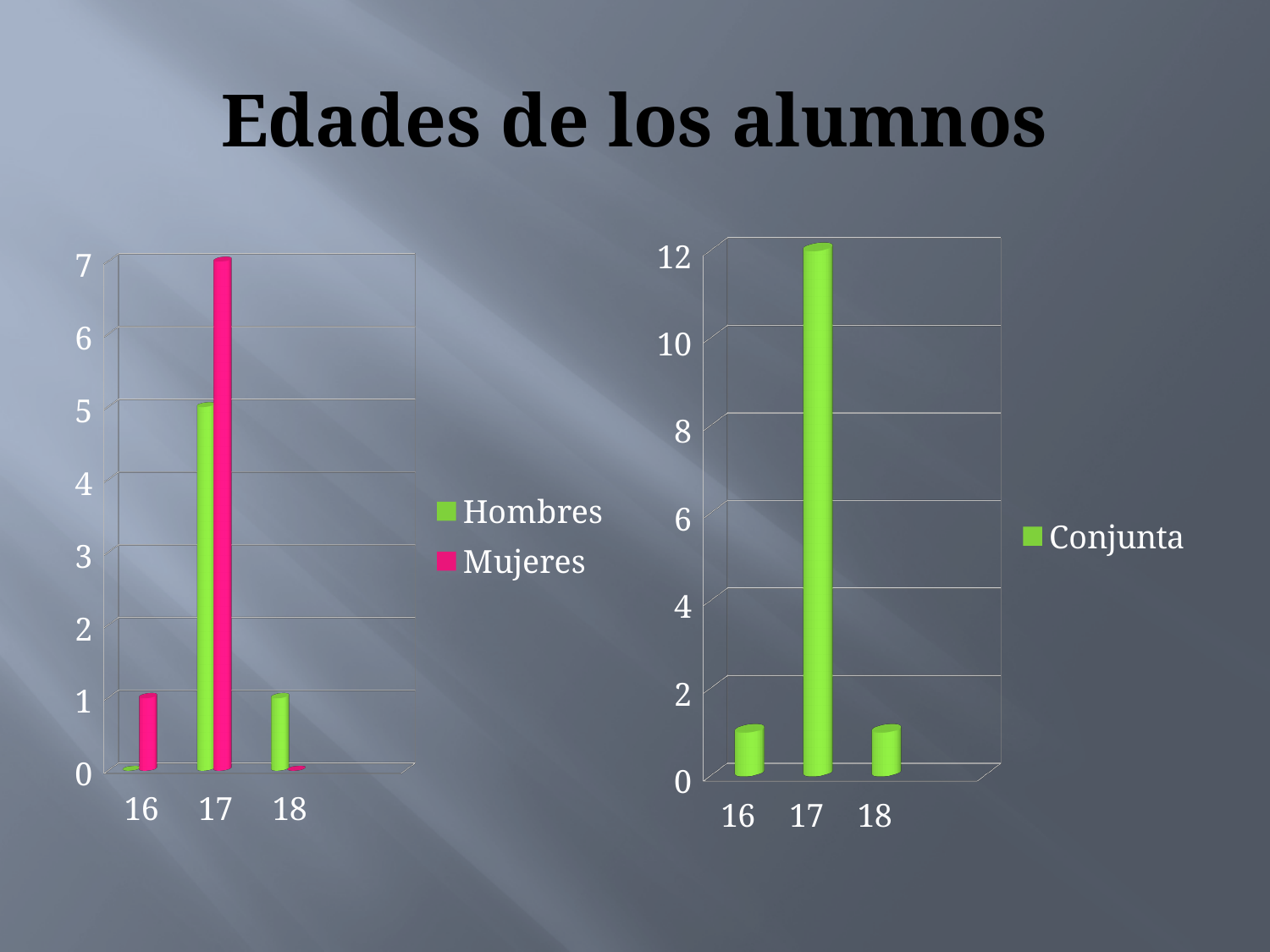
In the right chart, what is the value for Conjunta at age 17? 12 In the left chart, which series has the larger value at age 17, Hombres or Mujeres? Mujeres In the left chart, what is the value for Hombres at age 18? 1 In the left chart, what is the value for Mujeres at age 16? 1 In the left chart, what is the difference between Mujeres and Hombres at age 17? 2 In the left chart, how many series does the legend list? 2 What kind of chart is the right chart? bar chart In the right chart, which age has the highest value? 17 In the right chart, is the value for age 16 greater or less than 2? less In the left chart, what is the value for Hombres at age 17? 5 In the right chart, how many age categories are shown on the x axis? 3 In the left chart, what is the value for Mujeres at age 17? 7